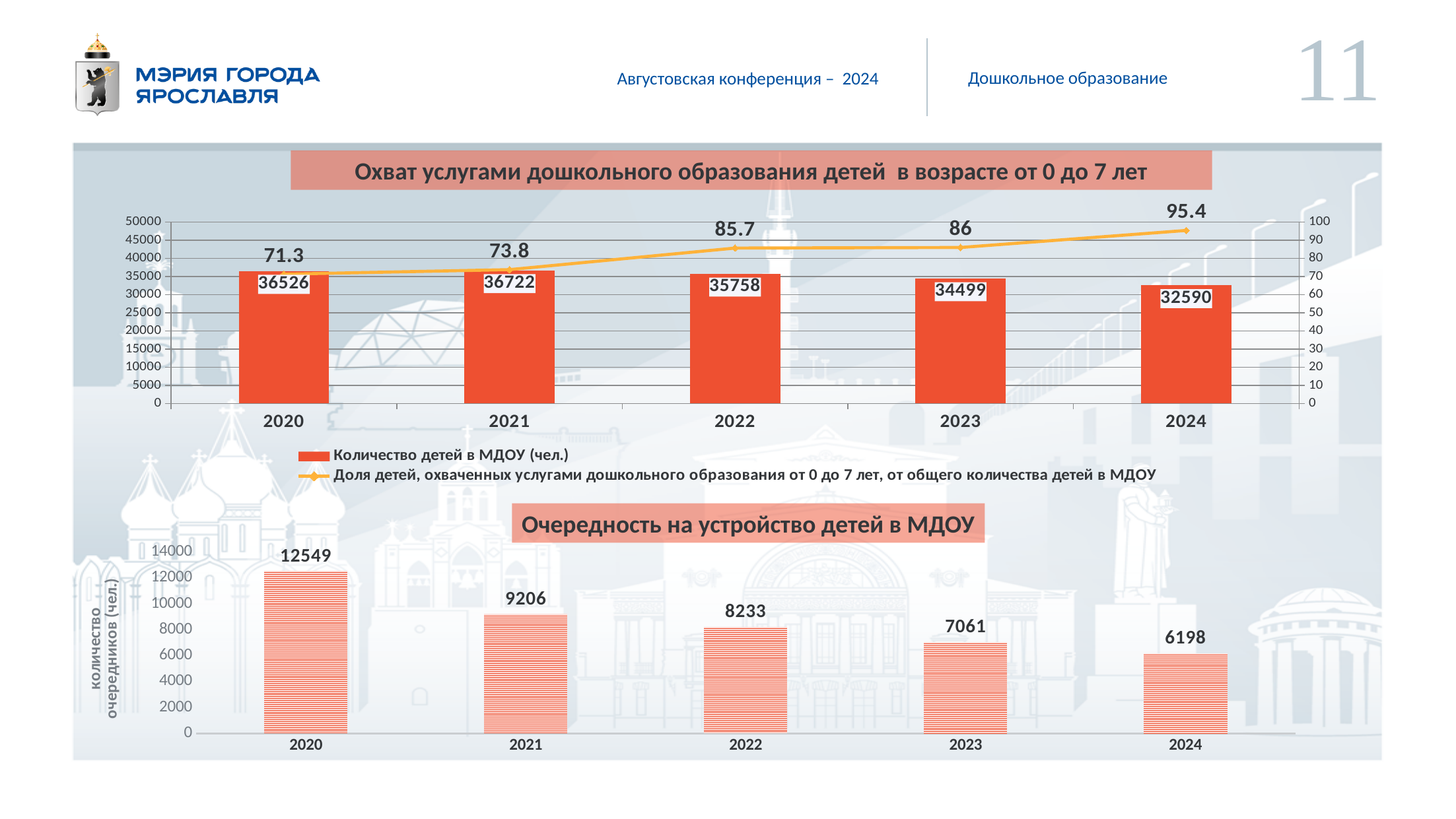
In the chart 'Охват услугами дошкольного образования детей в возрасте от 0 до 7 лет', which year has the highest value of 'Количество детей в МДОУ (чел.)'? 2021 In the chart 'Охват услугами дошкольного образования детей в возрасте от 0 до 7 лет', what is the value of the line series 'Доля детей, охваченных услугами дошкольного образования...' for 2024? 95.4 In the chart 'Охват услугами дошкольного образования детей в возрасте от 0 до 7 лет', which year has the lowest value of the line series (share of children)? 2020 In the chart 'Очередность на устройство детей в МДОУ', how many years are shown on the x axis? 5 In the chart 'Очередность на устройство детей в МДОУ', what is the value for 2022? 8233 What kind of chart is 'Очередность на устройство детей в МДОУ'? bar chart In the chart 'Охват услугами дошкольного образования детей в возрасте от 0 до 7 лет', what is the value of 'Количество детей в МДОУ (чел.)' for 2021? 36722 In the chart 'Охват услугами дошкольного образования детей в возрасте от 0 до 7 лет', how many series does the legend list? 2 In the chart 'Очередность на устройство детей в МДОУ', what is the difference between the values for 2020 and 2021? 3343 In the chart 'Очередность на устройство детей в МДОУ', which year has the lowest value? 2024 In the chart 'Охват услугами дошкольного образования детей в возрасте от 0 до 7 лет', what is the difference between 'Количество детей в МДОУ (чел.)' in 2020 and in 2024? 3936 In the chart 'Охват услугами дошкольного образования детей в возрасте от 0 до 7 лет', does the line series rise or fall from 2020 to 2024? rise